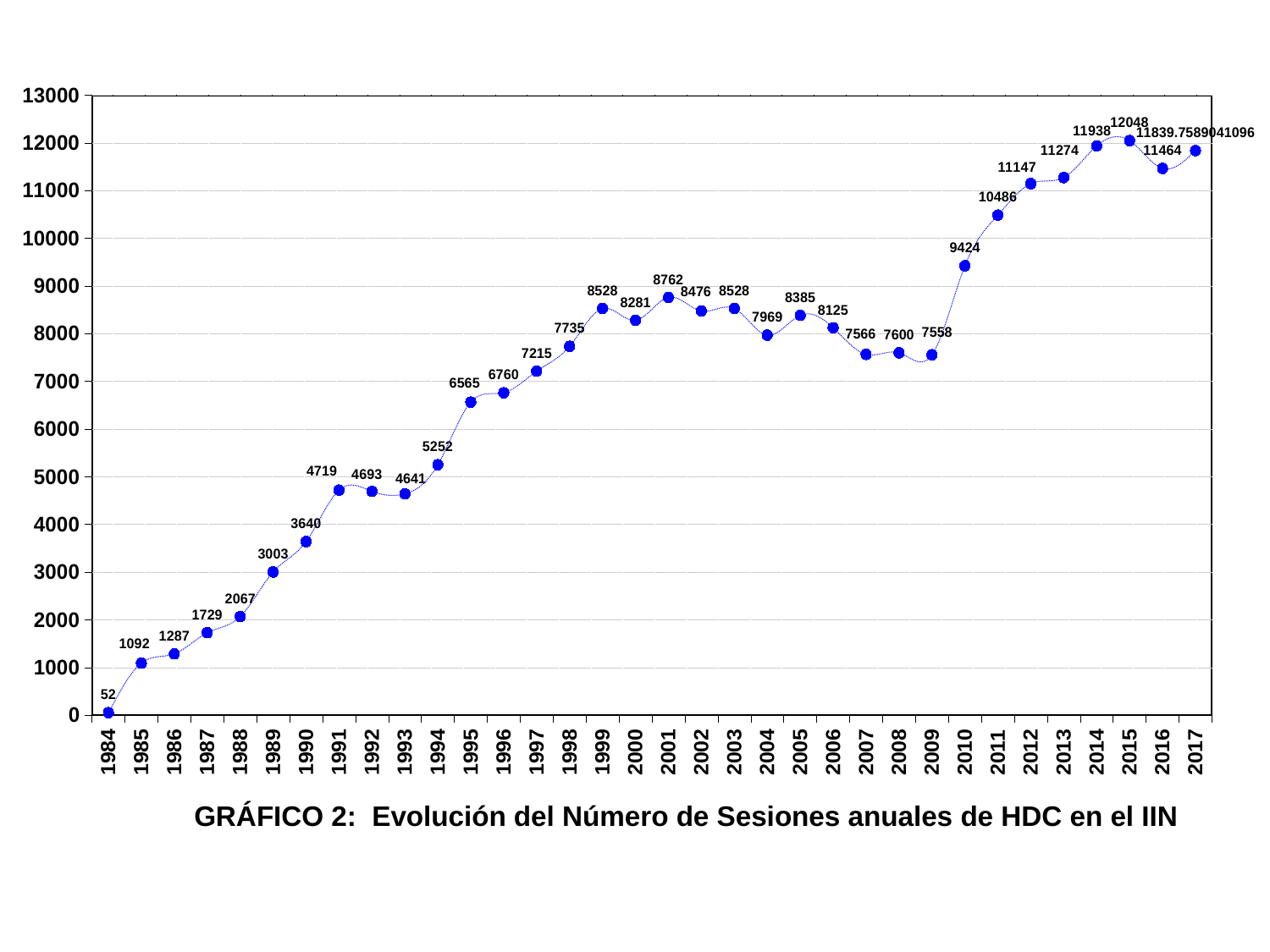
What is the title of the chart? GRÁFICO 2: Evolución del Número de Sesiones anuales de HDC en el IIN How many years are plotted on the x axis? 34 What type of chart is shown on the slide? line chart Which year has more sessions, 1999 or 2000? 1999 What is the number of sessions in 2001? 8762 What is the number of sessions in 2010? 9424 What is the difference between the number of sessions in 2011 and in 2010? 1062 Which year has the lowest number of sessions? 1984 Is the value for 2016 greater or less than 11000? greater What is the number of sessions in 1984? 52 What is the number of sessions in 1990? 3640 Which year has the highest number of sessions? 2015